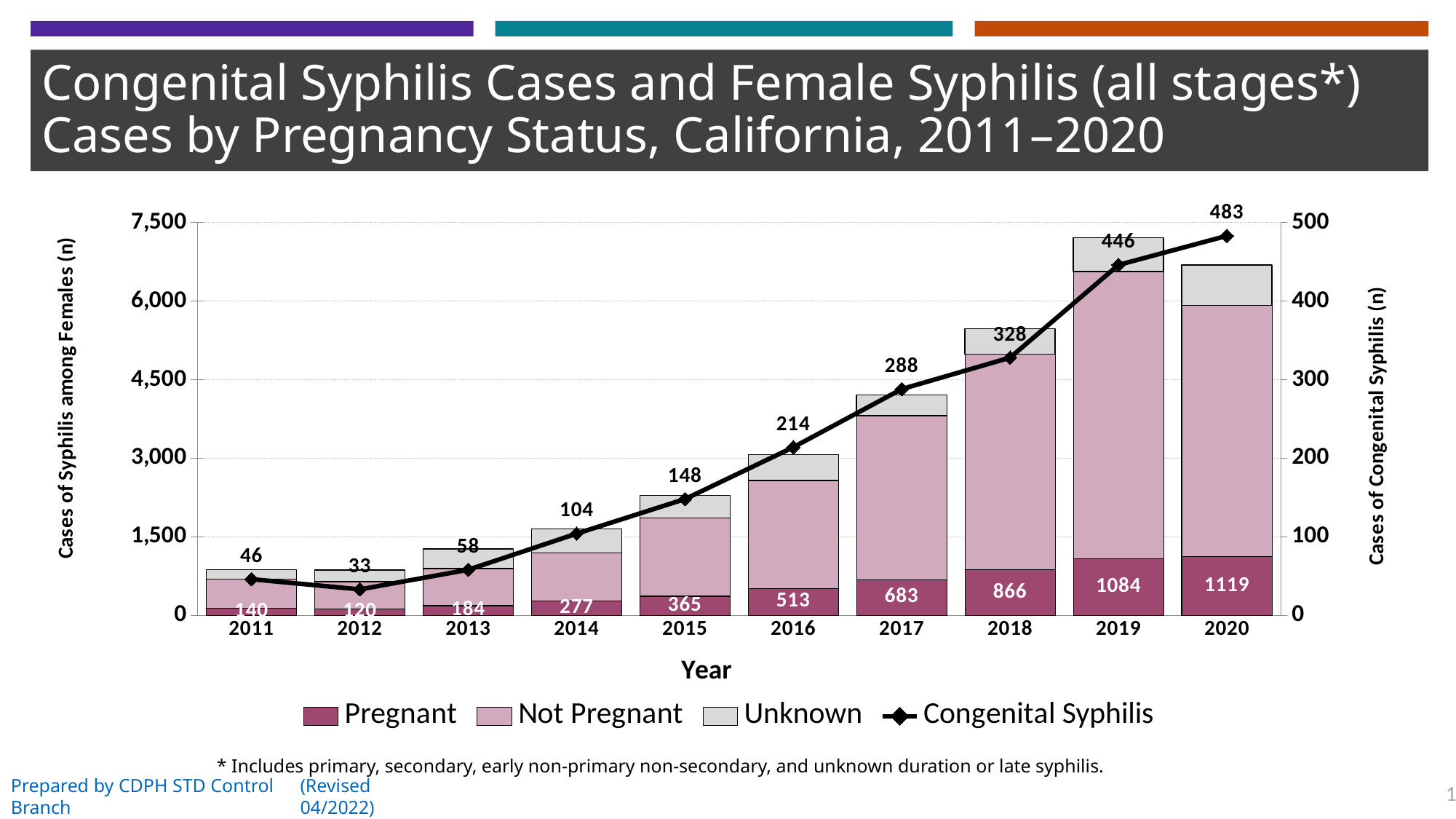
Is the total height of the stacked bar for 2019 greater or less than 6,000? greater Which year has the lowest Congenital Syphilis value? 2012 Does the Congenital Syphilis line generally rise or fall from 2012 to 2020? rise Which is larger, the Pregnant value for 2013 or for 2014? 2014 What is the difference between the Pregnant values for 2017 and 2016? 170 What is the difference between the Congenital Syphilis values for 2020 and 2019? 37 How many series does the legend list? 4 What is the title of the right-hand vertical axis? Cases of Congenital Syphilis (n) Which year has the highest Pregnant value? 2020 What is the Pregnant value for 2018? 866 What is the Congenital Syphilis value for 2016? 214 How many years are shown on the x axis? 10